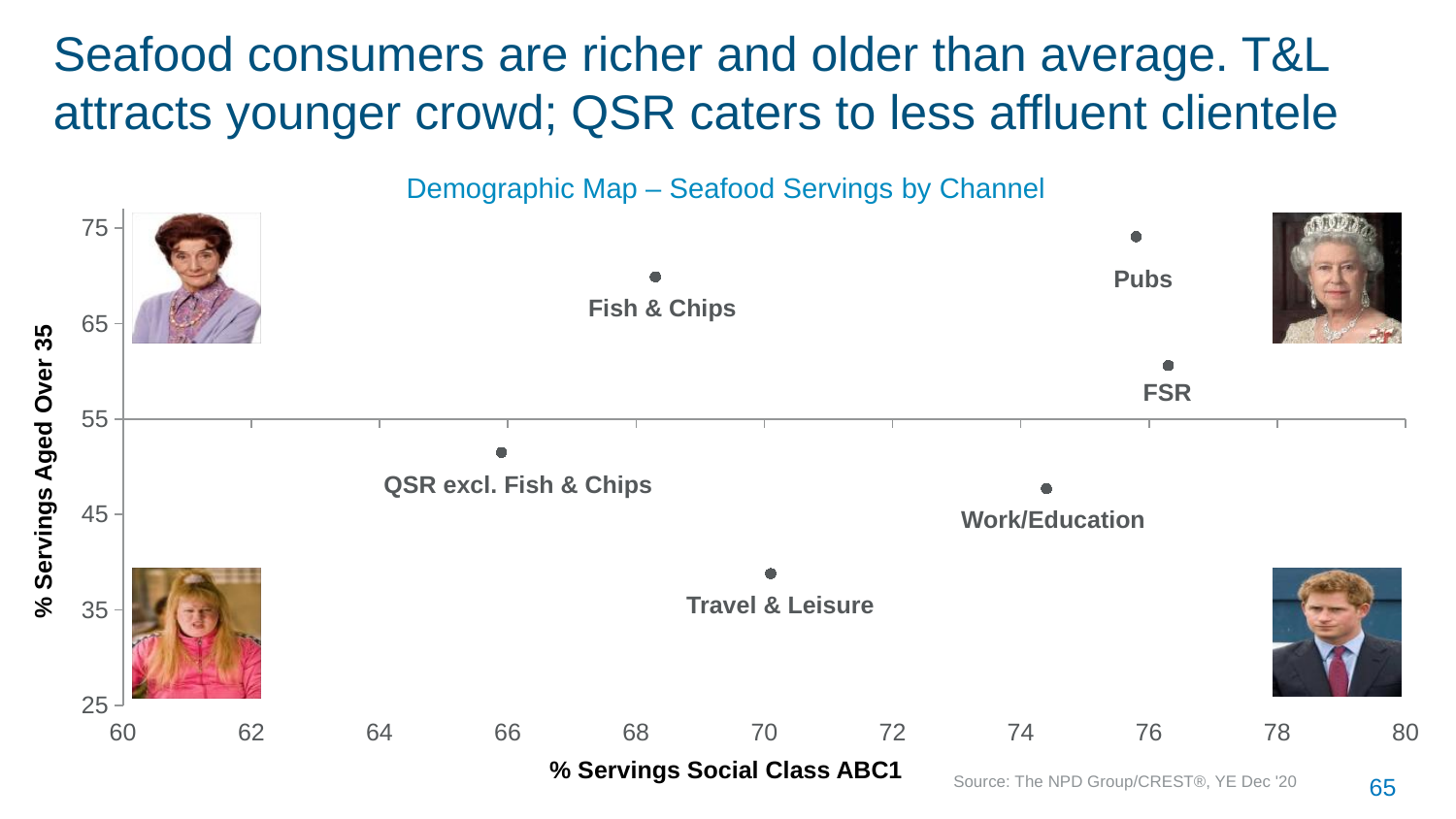
Which has a higher % Servings Aged Over 35, Fish & Chips or QSR excl. Fish & Chips? Fish & Chips Is the % Servings Social Class ABC1 for QSR excl. Fish & Chips greater or less than 68? less Is the % Servings Aged Over 35 for Travel & Leisure greater or less than 45? less Which has a higher % Servings Social Class ABC1, Work/Education or Travel & Leisure? Work/Education What is the title of the chart? Demographic Map – Seafood Servings by Channel Is the % Servings Social Class ABC1 for Pubs greater or less than 74? greater Which channel has the lowest % Servings Aged Over 35? Travel & Leisure What kind of chart is shown on the slide? Scatter chart Which channel has the highest % Servings Aged Over 35? Pubs How many channels are plotted as points on the chart? 6 Which channel has the lowest % Servings Social Class ABC1? QSR excl. Fish & Chips